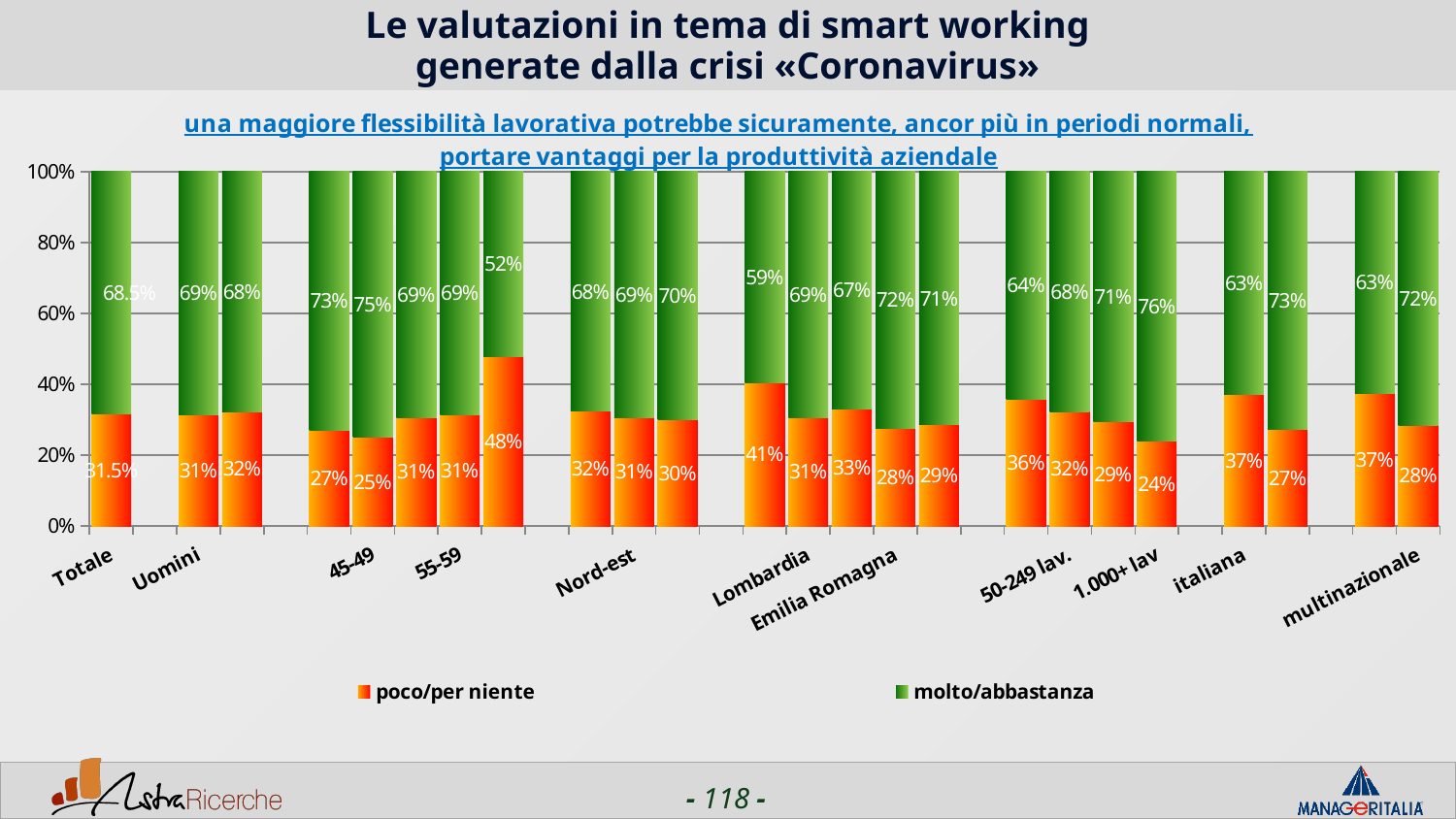
Which colour represents 'molto/abbastanza' in the legend? green Is the 'molto/abbastanza' value for Uomini greater or less than 60%? greater What is the 'poco/per niente' value for italiana? 37% Which has the larger 'poco/per niente' value, italiana or multinazionale? italiana What is the 'molto/abbastanza' value for Emilia Romagna? 72% What kind of chart is shown on the slide? stacked bar chart What is the 'molto/abbastanza' value for 1.000+ lav? 76% What is the total of the stacked bar for Totale? 100% How many series does the legend list? 2 What is the difference between the 'molto/abbastanza' values for 1.000+ lav and 50-249 lav.? 8 percentage points What is the 'poco/per niente' value for Totale? 31.5% What is the 'molto/abbastanza' value for Totale? 68.5%